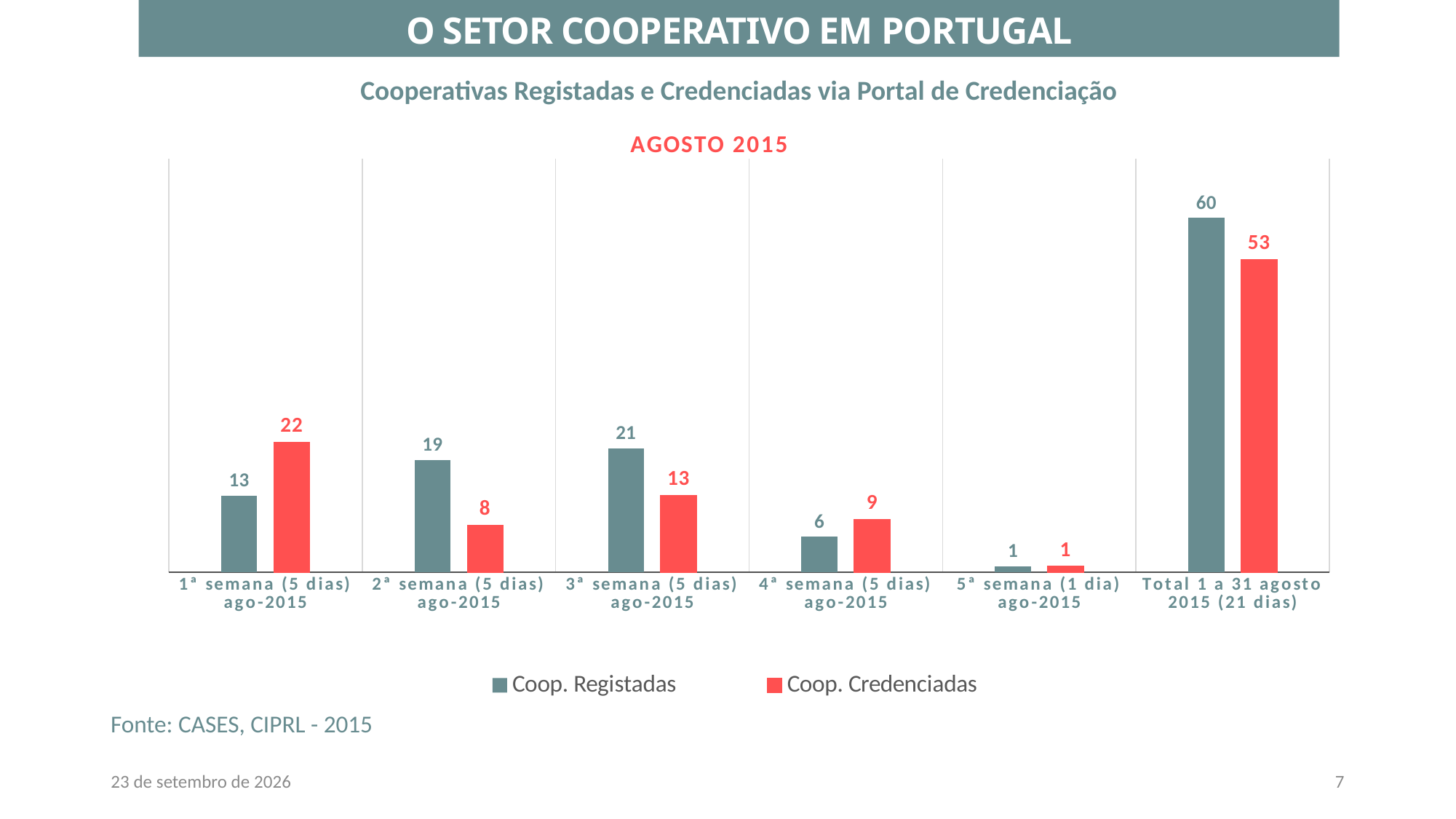
For 4ª semana (5 dias) ago-2015, which series has the larger value, Coop. Registadas or Coop. Credenciadas? Coop. Credenciadas How many categories are shown on the x axis? 6 What kind of chart is shown on the slide? Bar chart Which category has the lowest value for Coop. Credenciadas? 5ª semana (1 dia) ago-2015 How many series does the legend list? 2 What is the value of Coop. Registadas for 1ª semana (5 dias) ago-2015? 13 What colour are the Coop. Credenciadas bars? Red What is the value of Coop. Credenciadas for Total 1 a 31 agosto 2015 (21 dias)? 53 What is the difference between Coop. Registadas and Coop. Credenciadas for 2ª semana (5 dias) ago-2015? 11 What is the difference between Coop. Registadas and Coop. Credenciadas for Total 1 a 31 agosto 2015 (21 dias)? 7 What is the value of Coop. Credenciadas for 3ª semana (5 dias) ago-2015? 13 Among the weekly categories (excluding the total), which week has the highest value for Coop. Registadas? 3ª semana (5 dias) ago-2015